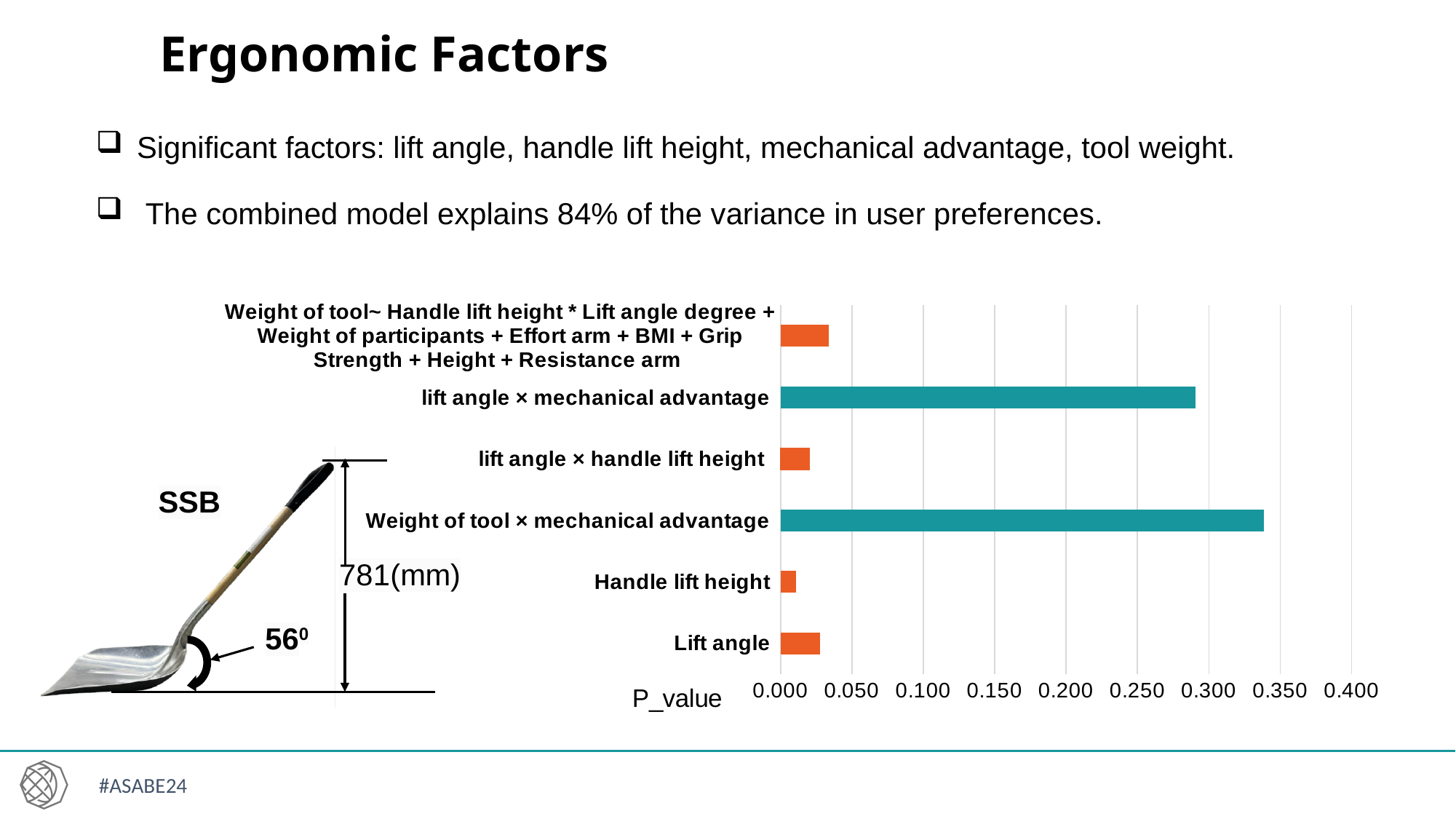
Which category has the highest P_value in the chart? Weight of tool × mechanical advantage What is the highest tick value shown on the horizontal axis of the chart? 0.400 How many categories (bars) does the chart show? 6 Which has a larger P_value: lift angle × mechanical advantage or lift angle × handle lift height? lift angle × mechanical advantage Is the P_value for Weight of tool × mechanical advantage greater or less than 0.300? greater Is the P_value for Lift angle greater or less than 0.050? less Which has a larger P_value: Lift angle or Handle lift height? Lift angle Is the P_value for lift angle × handle lift height greater or less than 0.050? less What kind of chart is shown on the slide? bar chart What is the label on the horizontal axis of the chart? P_value Which category has the lowest P_value in the chart? Handle lift height